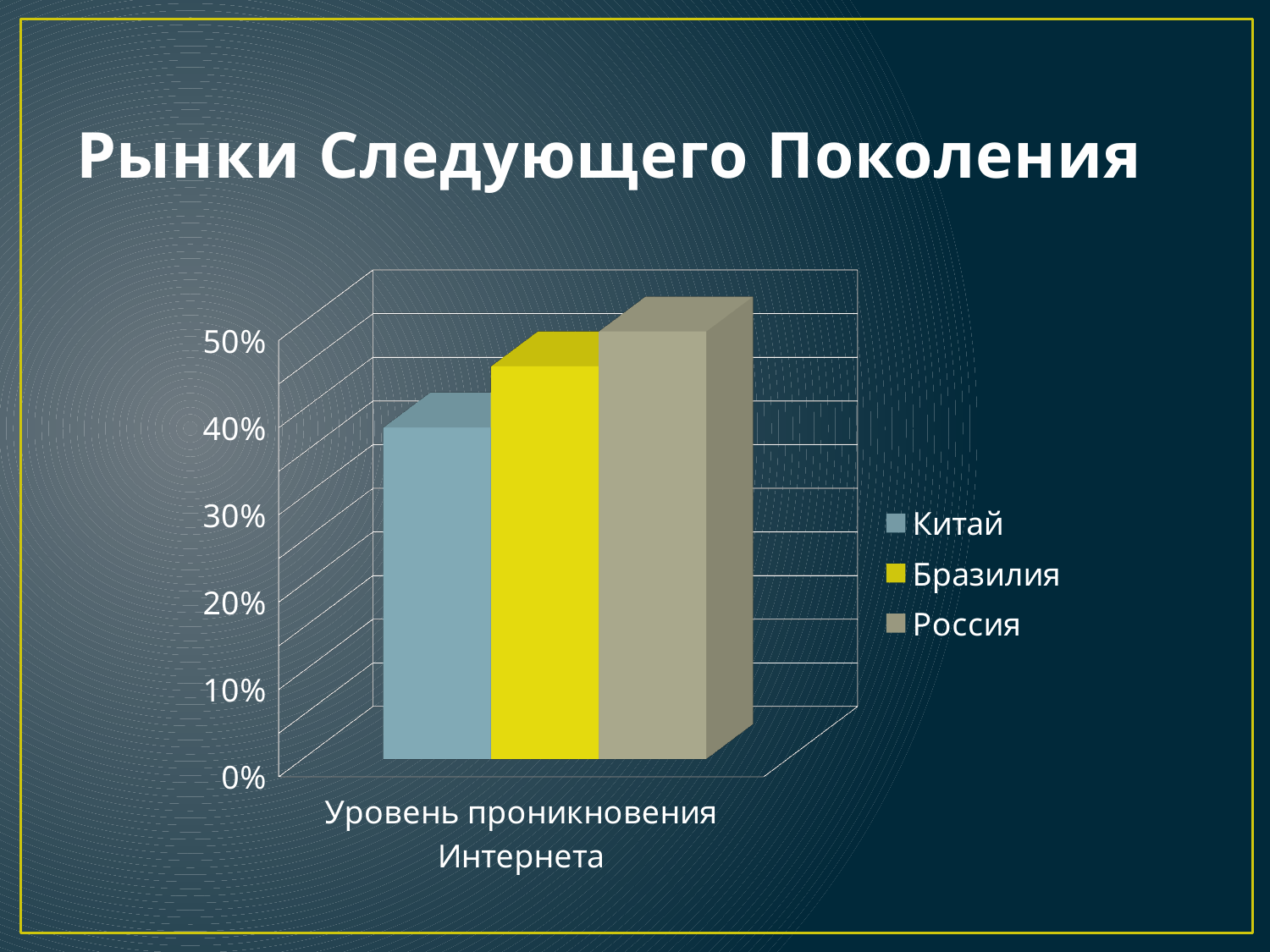
What kind of chart is shown on the slide? Bar chart Is the value for Россия greater or less than 40%? greater Which is larger, the value for Россия or the value for Бразилия? Россия What is the title of the slide containing the chart? Рынки Следующего Поколения Which is larger, the value for Бразилия or the value for Китай? Бразилия Is the value for Бразилия greater or less than 40%? greater Which country has the highest Internet penetration level in the chart? Россия Which country has the lowest Internet penetration level in the chart? Китай Is the value for Китай greater or less than 30%? greater How many series does the legend list? 3 What is the label of the category on the x axis? Уровень проникновения Интернета How many categories are shown on the x axis? 1